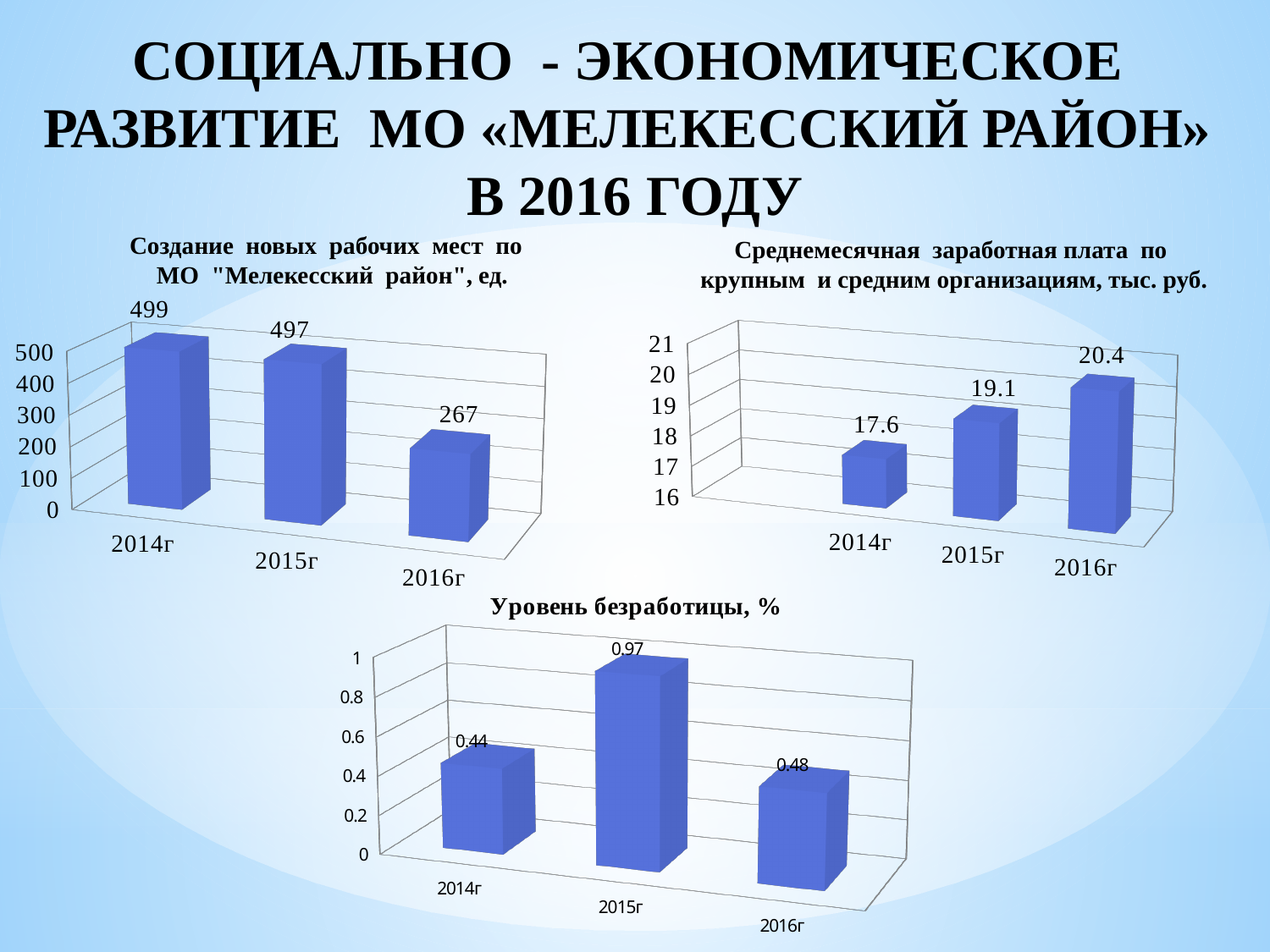
In the chart 'Уровень безработицы, %', what is the value for 2015г? 0.97 In the chart 'Создание новых рабочих мест по МО "Мелекесский район", ед.', what is the value for 2014г? 499 How many charts are on the slide? 3 In the chart 'Уровень безработицы, %', which year has the highest value? 2015г In the chart 'Создание новых рабочих мест по МО "Мелекесский район", ед.', which year has the lowest value? 2016г In the chart 'Среднемесячная заработная плата по крупным и средним организациям, тыс. руб.', do the values rise or fall from 2014г to 2016г? rise In the chart 'Уровень безработицы, %', which is larger, the value for 2014г or the value for 2016г? 2016г In the chart 'Создание новых рабочих мест по МО "Мелекесский район", ед.', what is the difference between the values for 2015г and 2016г? 230 In the chart 'Среднемесячная заработная плата по крупным и средним организациям, тыс. руб.', what is the value for 2016г? 20.4 What kind of chart is 'Создание новых рабочих мест по МО "Мелекесский район", ед.'? bar chart In the chart 'Среднемесячная заработная плата по крупным и средним организациям, тыс. руб.', what is the difference between the values for 2016г and 2014г? 2.8 In the chart 'Уровень безработицы, %', how many years are shown? 3